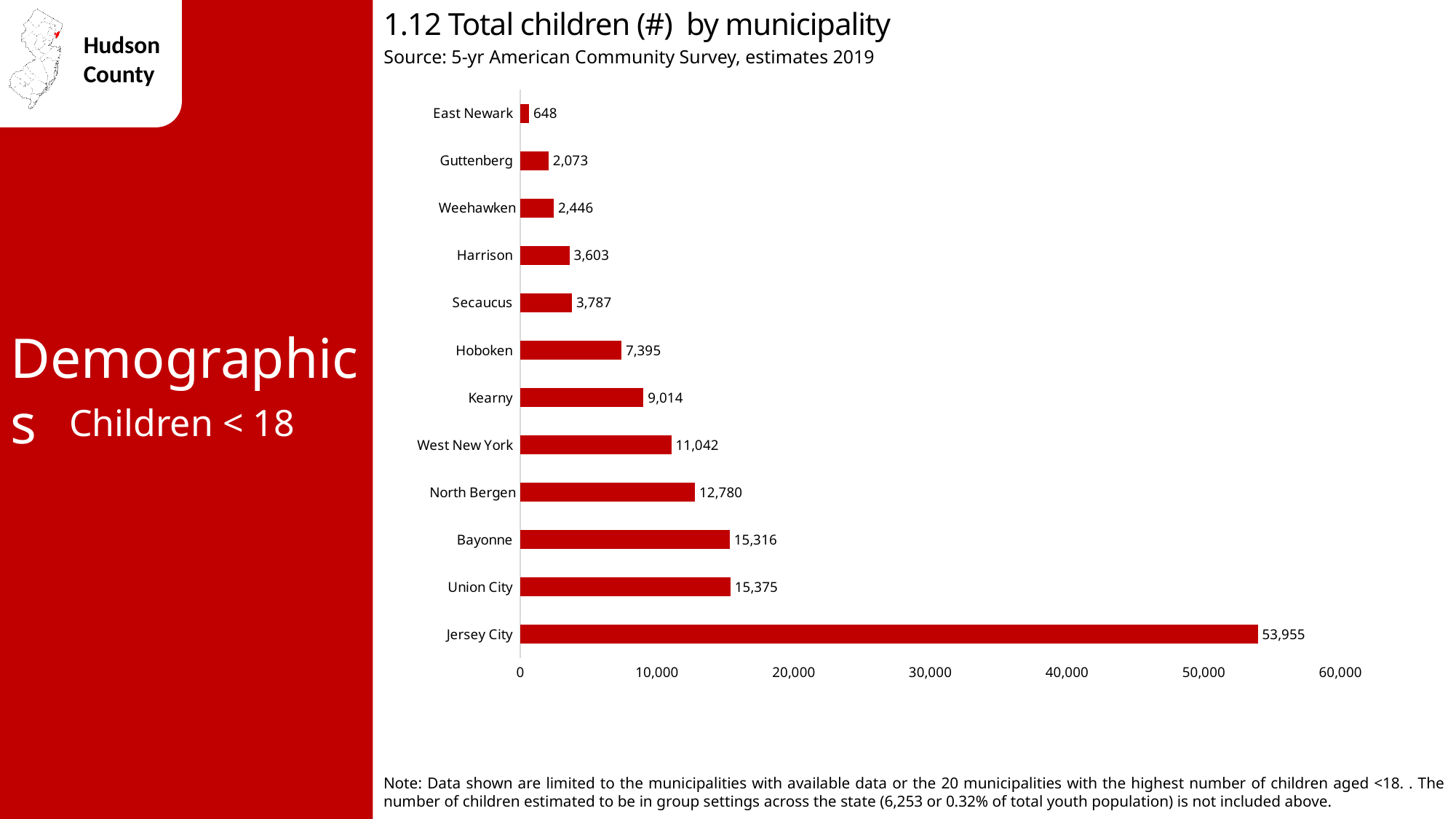
What type of chart is used to show total children by municipality? Bar chart Which has more children, West New York or Kearny? West New York What is the total number of children in North Bergen? 12,780 What is the total number of children in Hoboken? 7,395 Which municipality has the lowest number of children? East Newark How many municipalities are shown in the chart? 12 What is the source of the data in the chart? 5-yr American Community Survey, estimates 2019 Is the value for Bayonne greater or less than 20,000? less What is the maximum value shown on the horizontal axis? 60,000 What is the difference in the number of children between Union City and Bayonne? 59 What is the difference in the number of children between Jersey City and Kearny? 44,941 Which municipality has the highest number of children? Jersey City